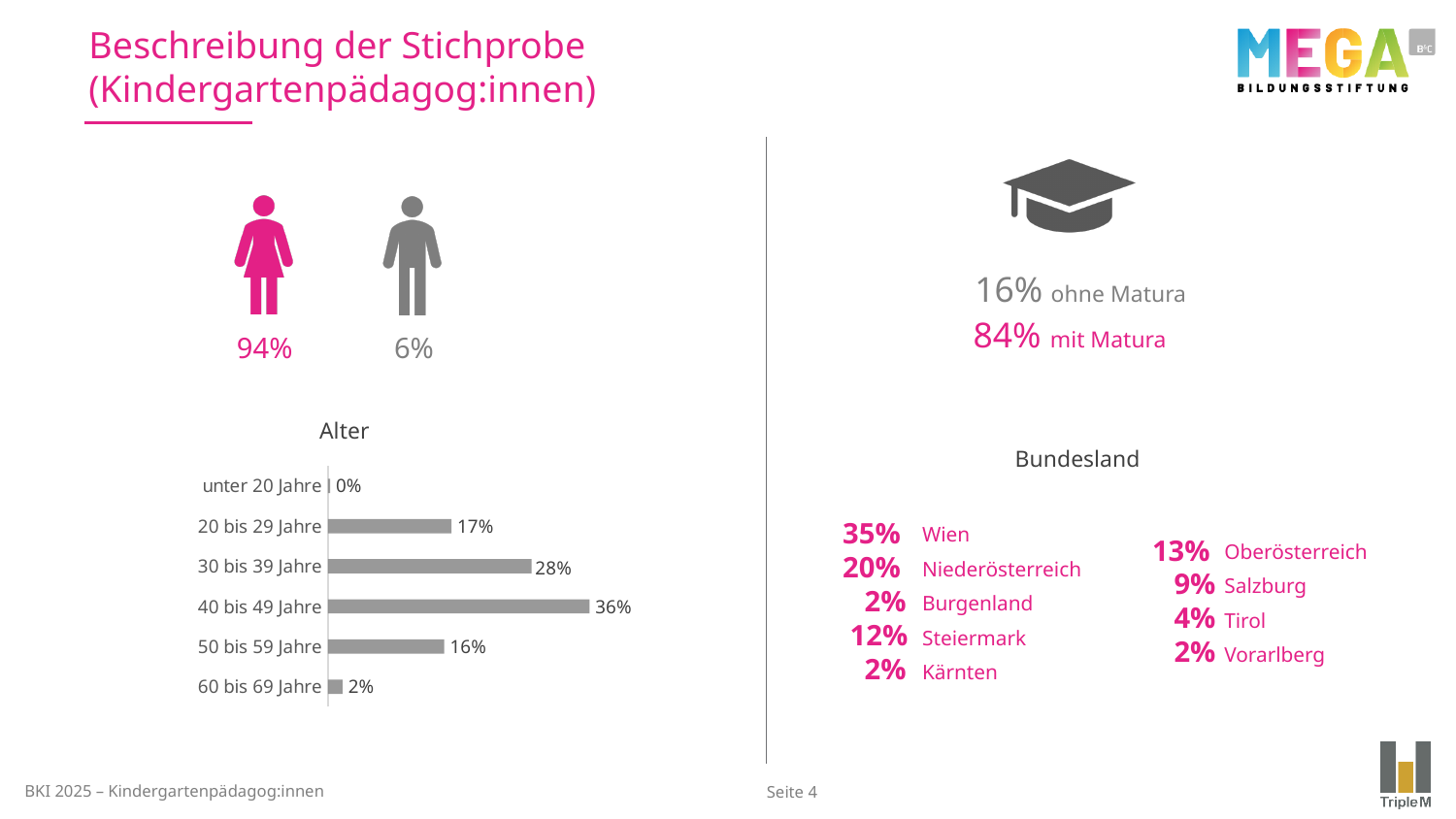
In the "Alter" chart, which age group has the highest value? 40 bis 49 Jahre In the "Alter" chart, what is the value for 40 bis 49 Jahre? 36% In the "Alter" chart, what is the value for 20 bis 29 Jahre? 17% In the "Alter" chart, which is larger: the value for 30 bis 39 Jahre or the value for 50 bis 59 Jahre? 30 bis 39 Jahre In the "Alter" chart, what is the difference between the values for 20 bis 29 Jahre and 50 bis 59 Jahre? 1% In the "Alter" chart, which age group has the lowest value? unter 20 Jahre In the "Alter" chart, what is the difference between the values for 40 bis 49 Jahre and 30 bis 39 Jahre? 8% What kind of chart is the "Alter" chart? bar chart How many age categories are shown in the "Alter" chart? 6 In the "Alter" chart, what is the value for 60 bis 69 Jahre? 2% In the "Alter" chart, what is the value for unter 20 Jahre? 0% What is the title of the bar chart on the left side of the slide? Alter